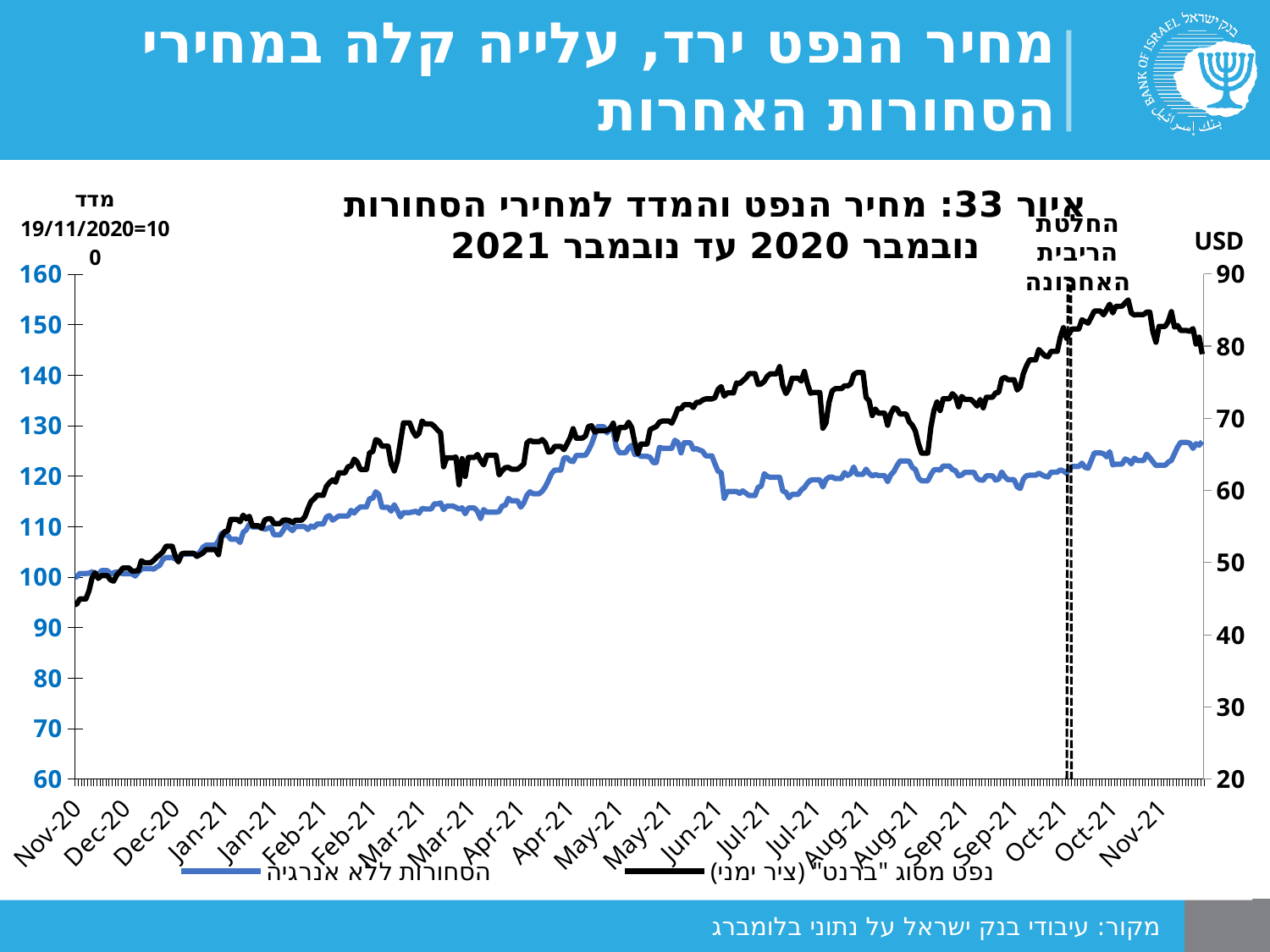
How many series does the legend list? 2 Overall, does the black line for Brent oil rise or fall from Nov-20 to Oct-21? rise What unit is shown at the top of the right-hand axis? USD Is the peak of the black Brent oil line in Oct-21 greater or less than 80 on the right axis? greater What is the lowest value shown on the left-hand axis? 60 What kind of chart is shown on the slide? line chart Is the value of the blue הסחורות ללא אנרגיה line at the end of the series (Nov-21) greater or less than 120 on the left axis? greater Is the value of the blue הסחורות ללא אנרגיה line in Jul-21 greater or less than 130 on the left axis? less Which series does the legend say is plotted on the right axis? נפט מסוג "ברנט" Overall, does the blue line for הסחורות ללא אנרגיה rise or fall from Nov-20 to Nov-21? rise What is the figure number given in the chart title? 33